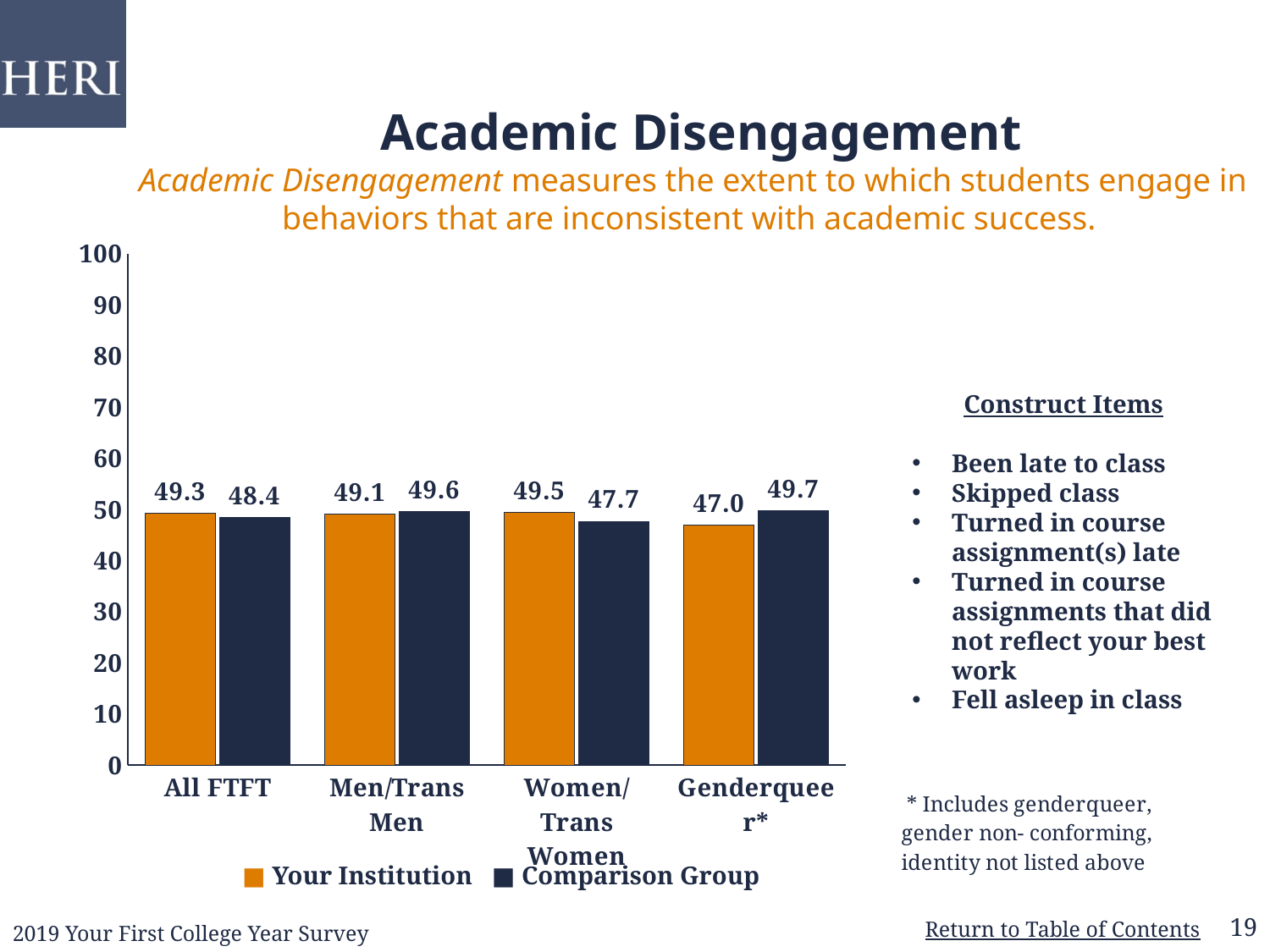
What is the Comparison Group value for Women/Trans Women? 47.7 Which category has the lowest Comparison Group value? Women/Trans Women For Women/Trans Women, which is larger: Your Institution or Comparison Group? Your Institution What is the Comparison Group value for Men/Trans Men? 49.6 What is the difference between the Comparison Group and Your Institution values for Genderqueer*? 2.7 What is the difference between the Your Institution and Comparison Group values for All FTFT? 0.9 How many series does the legend list? 2 What kind of chart is shown on the slide? Bar chart What is the Your Institution value for Genderqueer*? 47.0 How many categories are shown on the x axis? 4 Which category has the lowest Your Institution value? Genderqueer* What is the Your Institution value for All FTFT? 49.3